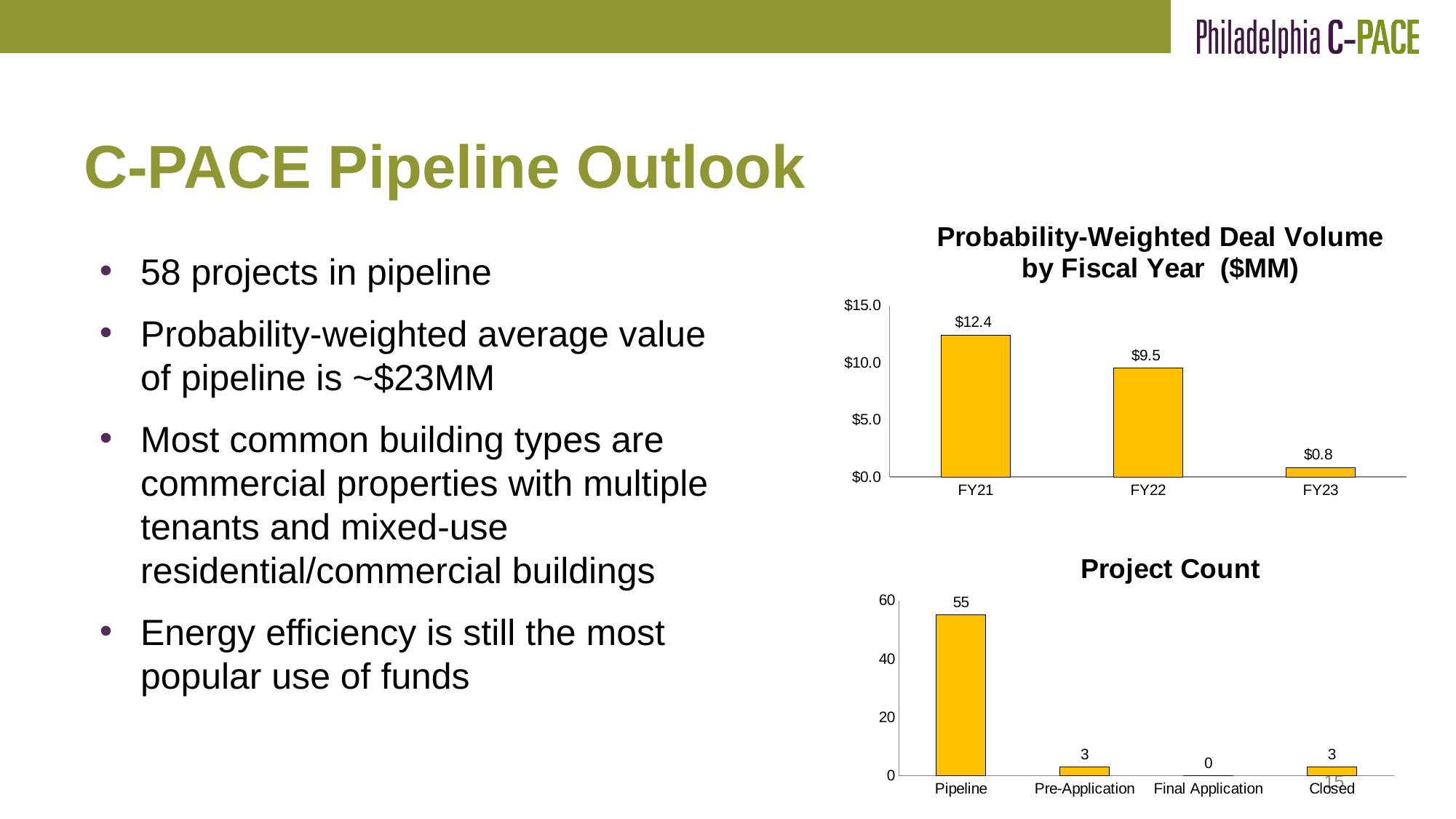
In the 'Probability-Weighted Deal Volume by Fiscal Year ($MM)' chart, what is the value for FY21? $12.4 In the 'Project Count' chart, what is the difference between Pipeline and Closed? 52 In the 'Probability-Weighted Deal Volume by Fiscal Year ($MM)' chart, which fiscal year has the highest value? FY21 In the 'Project Count' chart, what is the value for Pipeline? 55 In the 'Probability-Weighted Deal Volume by Fiscal Year ($MM)' chart, do the values rise or fall from FY21 to FY23? fall What type of chart is the 'Project Count' chart? bar chart In the 'Probability-Weighted Deal Volume by Fiscal Year ($MM)' chart, what is the value for FY23? $0.8 In the 'Probability-Weighted Deal Volume by Fiscal Year ($MM)' chart, how many fiscal years are shown? 3 In the 'Probability-Weighted Deal Volume by Fiscal Year ($MM)' chart, what is the difference between FY21 and FY22? $2.9 In the 'Project Count' chart, which category has the lowest value? Final Application In the 'Project Count' chart, what is the value for Final Application? 0 In the 'Project Count' chart, how many categories are shown on the x axis? 4